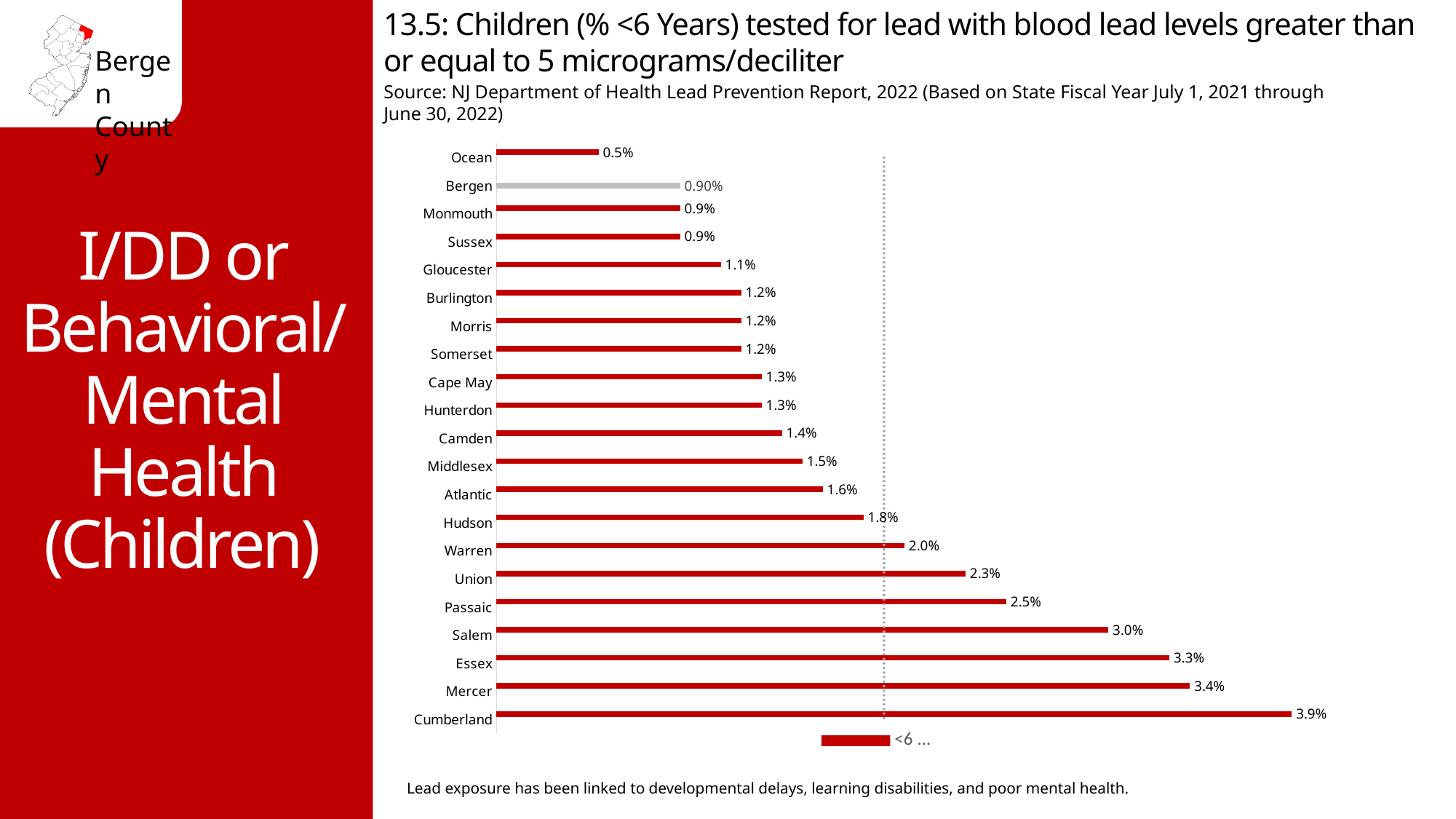
What is the difference between the values for Cumberland and Ocean? 3.4 percentage points Which county's bar is shown in grey rather than red? Bergen What is the value for Cumberland? 3.9% What is the difference between the values for Passaic and Union? 0.2 percentage points What is the value for Bergen? 0.90% Which is larger, the value for Atlantic or the value for Camden? Atlantic What kind of chart is shown on the slide? Bar chart Which is larger, the value for Essex or the value for Salem? Essex What is the value for Hudson? 1.8% How many counties are shown in the chart? 21 Which county has the lowest value? Ocean Which county has the highest value? Cumberland